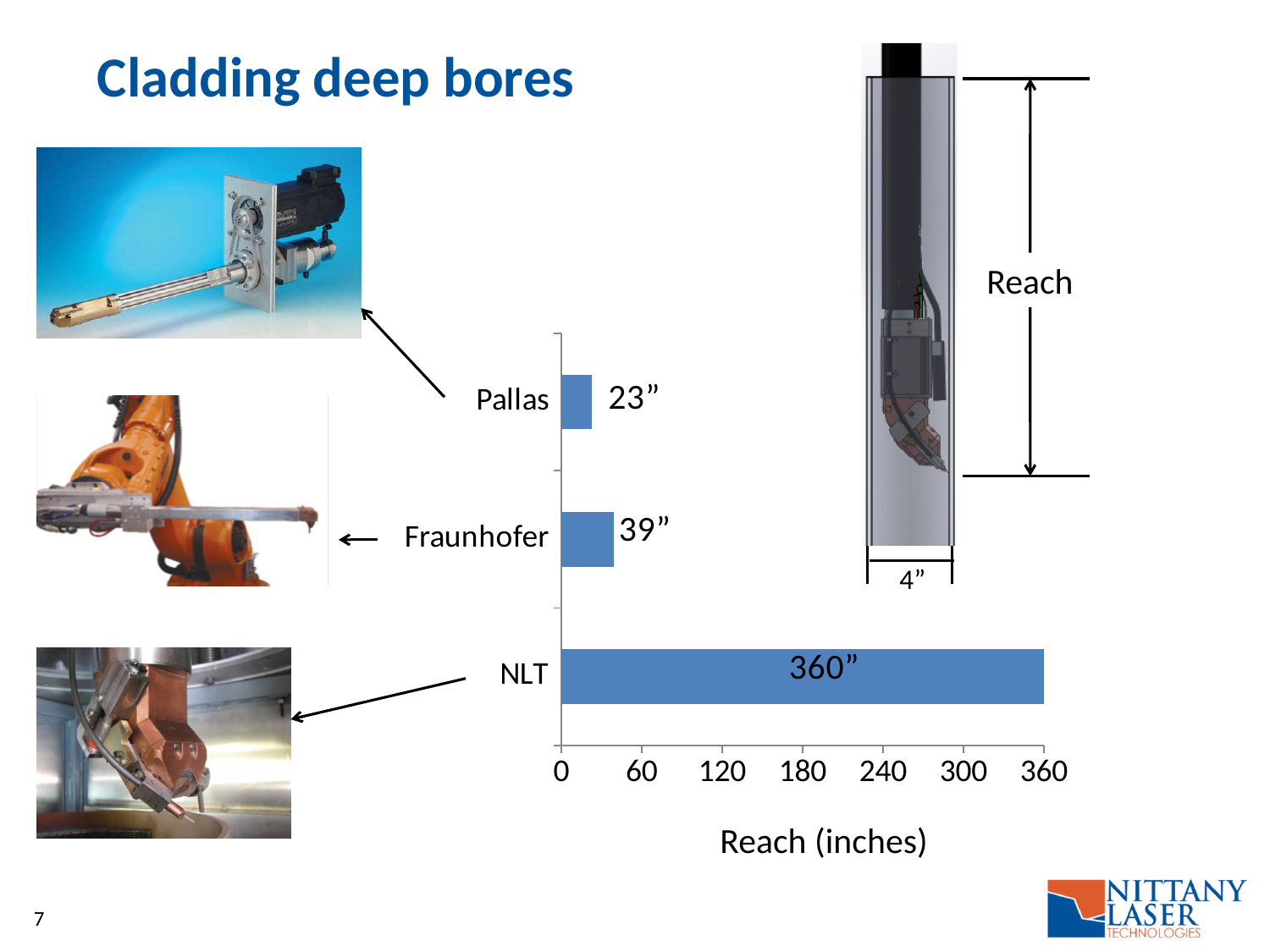
What is the difference in reach between Fraunhofer and Pallas? 16" What is the reach value shown for NLT? 360" What is the reach value shown for Fraunhofer? 39" Which category has the highest reach? NLT What is the difference in reach between NLT and Fraunhofer? 321" Which has a larger reach, Pallas or Fraunhofer? Fraunhofer Which category has the lowest reach? Pallas How many categories are shown in the chart? 3 What kind of chart is shown on the slide? bar chart What is the reach value shown for Pallas? 23" Is the value for NLT greater or less than 300? greater What is the label of the horizontal axis of the chart? Reach (inches)